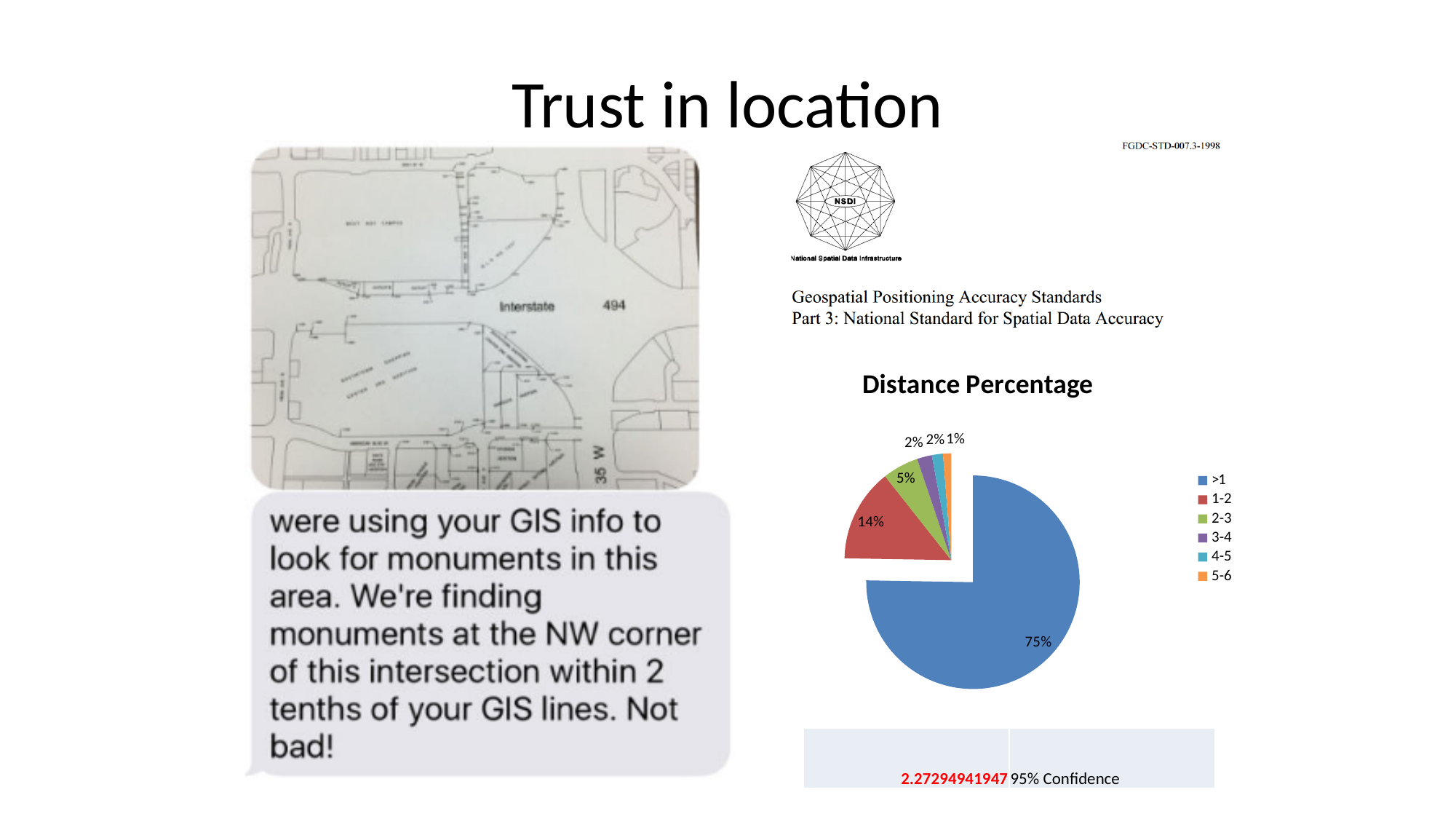
What kind of chart is shown under the title "Distance Percentage"? pie chart What percentage does the "1-2" slice represent in the Distance Percentage pie chart? 14% What percentage does the "5-6" slice represent in the Distance Percentage pie chart? 1% What percentage does the ">1" slice represent in the Distance Percentage pie chart? 75% What percentage does the "2-3" slice represent in the Distance Percentage pie chart? 5% In the Distance Percentage pie chart, what is the difference between the ">1" slice and the "1-2" slice? 61% What colour is the ">1" slice in the Distance Percentage pie chart? blue How many slices does the Distance Percentage pie chart have? 6 Which category has the smallest slice in the Distance Percentage pie chart? 5-6 What is the title of the pie chart on the slide? Distance Percentage In the Distance Percentage pie chart, which slice is larger: "1-2" or "2-3"? 1-2 Which category has the largest slice in the Distance Percentage pie chart? >1